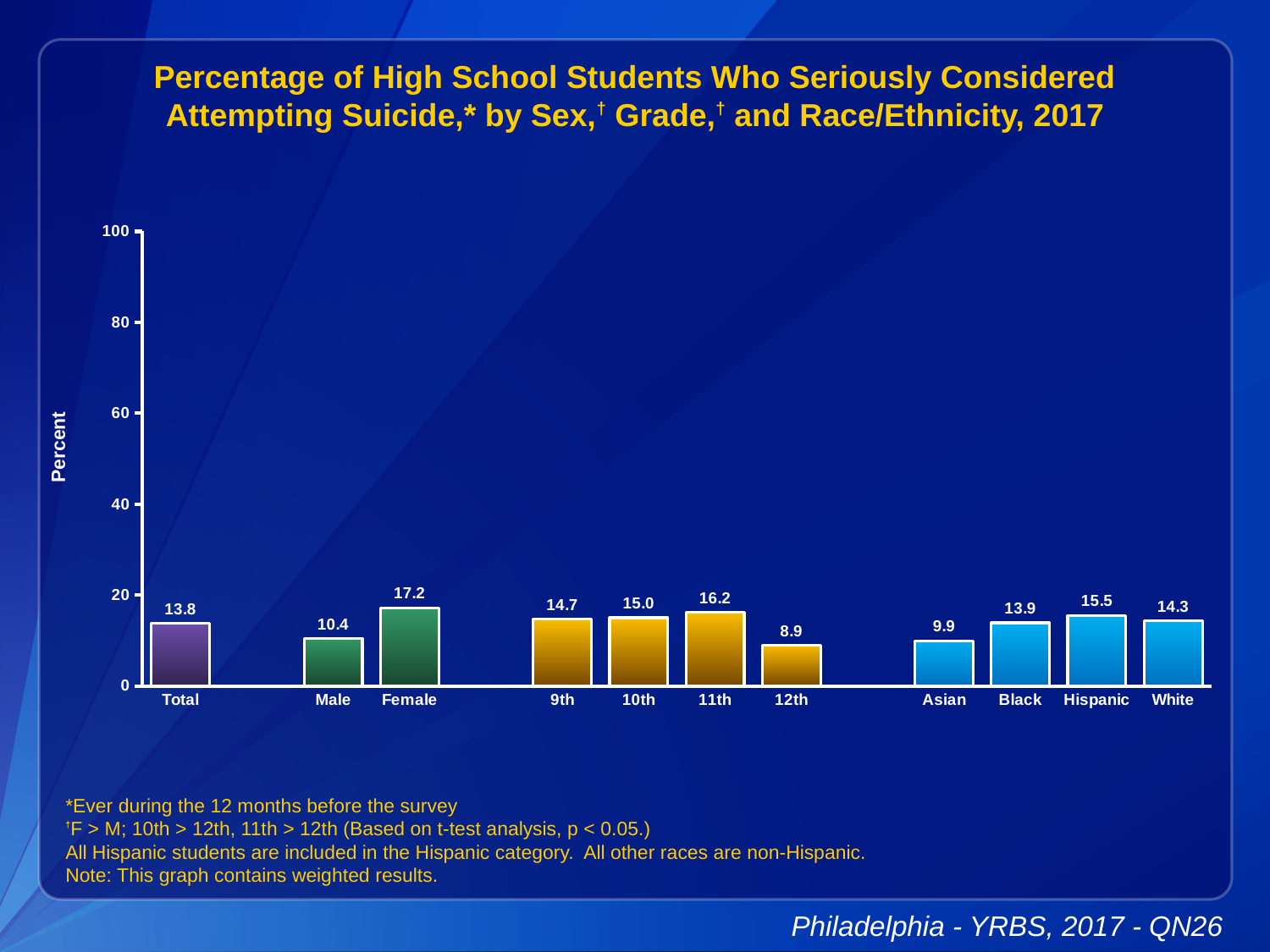
What is the value for 12th grade? 8.9 Which is larger, the value for Hispanic or the value for White? Hispanic What is the difference between the Female and Male values? 6.8 What is the value for Total? 13.8 What is the value for Female? 17.2 How many categories are shown on the x axis? 11 Is the value for Female greater or less than 20? less What kind of chart is this? bar chart What is the value for Asian students? 9.9 Which category has the lowest value? 12th Which category has the highest value? Female What is the difference between the 11th grade and 12th grade values? 7.3